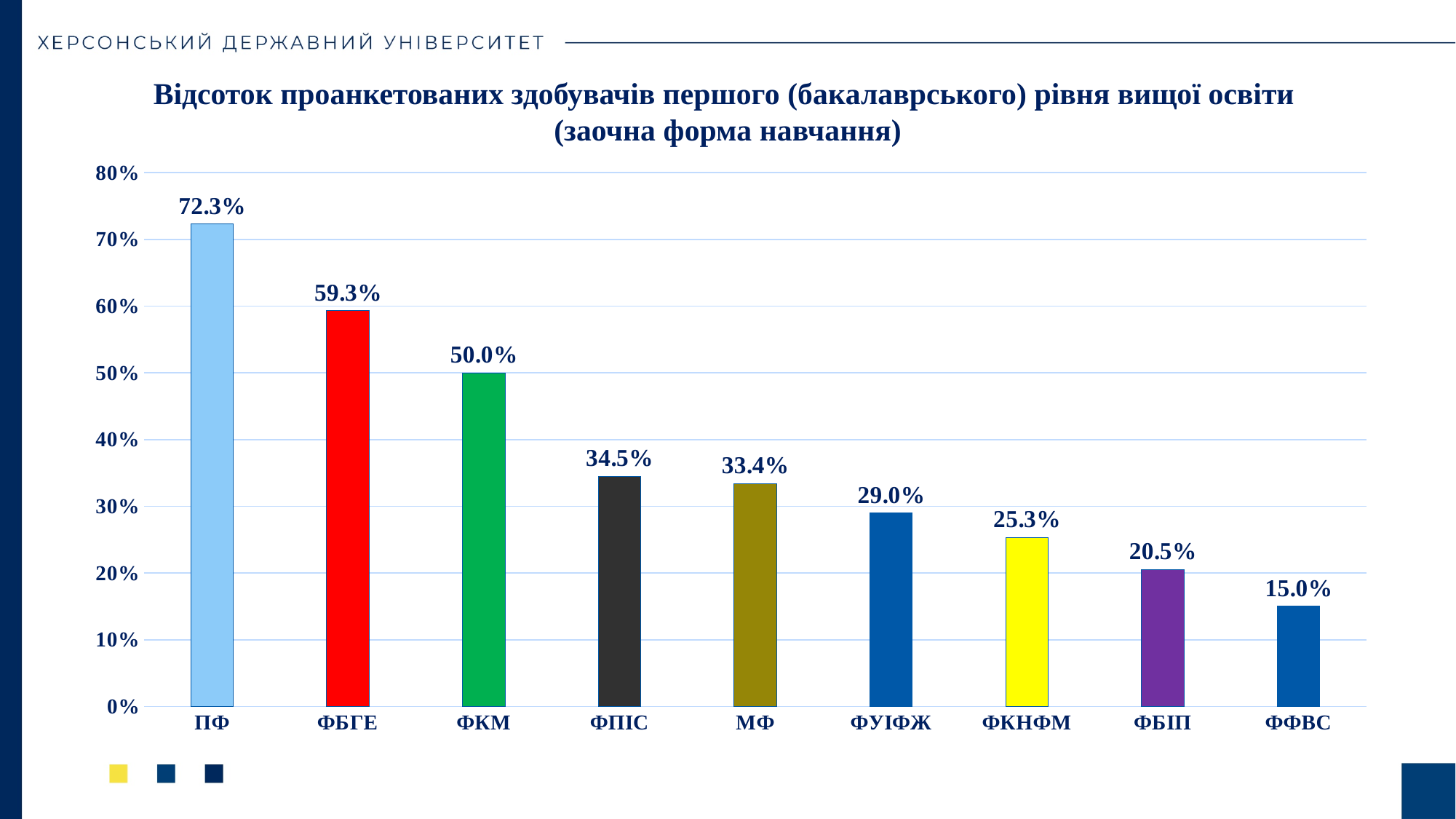
What colour is the bar for ФБГЕ? red Which is larger, the value for ФУІФЖ or the value for ФБІП? ФУІФЖ What is the difference between the values for ФБГЕ and ФКМ? 9.3% Do the values rise or fall from left to right along the x axis? fall What is the value for МФ? 33.4% Which category has the lowest value? ФФВС What is the value for ФКНФМ? 25.3% What kind of chart is shown on the slide? bar chart Is the value for ФПІС greater or less than 30%? greater How many categories are shown on the x axis? 9 What is the value for ПФ? 72.3% Which category has the highest value? ПФ